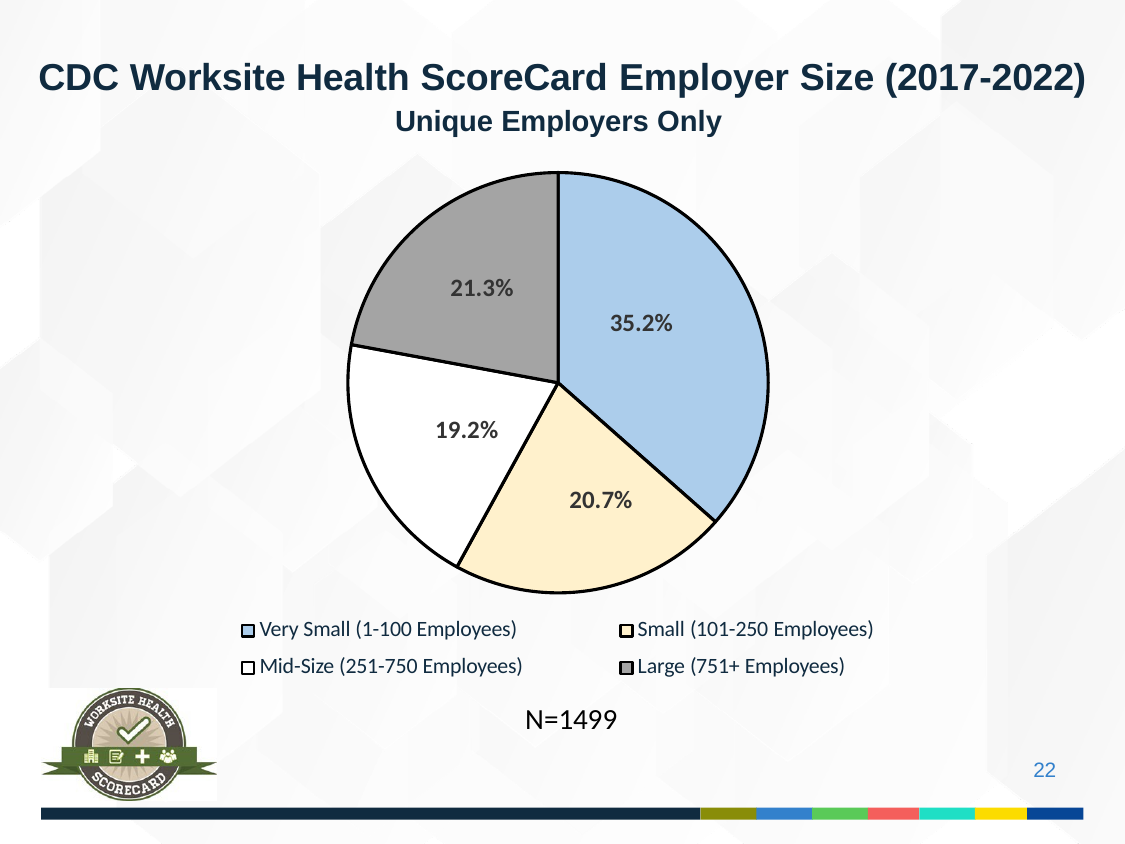
What share of unique employers are Large (751+ Employees)? 21.3% Which employer size category has the largest share of the pie? Very Small (1-100 Employees) Which has a larger share, Large (751+ Employees) or Small (101-250 Employees)? Large (751+ Employees) What colour is the slice for Large (751+ Employees)? Gray What share of unique employers are Very Small (1-100 Employees)? 35.2% What is the difference in percentage points between the Very Small and Mid-Size shares? 16 percentage points What type of chart is shown on the slide? Pie chart What is the total number of unique employers (N) stated below the chart? N=1499 What share of unique employers are Mid-Size (251-750 Employees)? 19.2% How many employer size categories are shown in the pie chart? 4 What share of unique employers are Small (101-250 Employees)? 20.7% Which employer size category has the smallest share of the pie? Mid-Size (251-750 Employees)